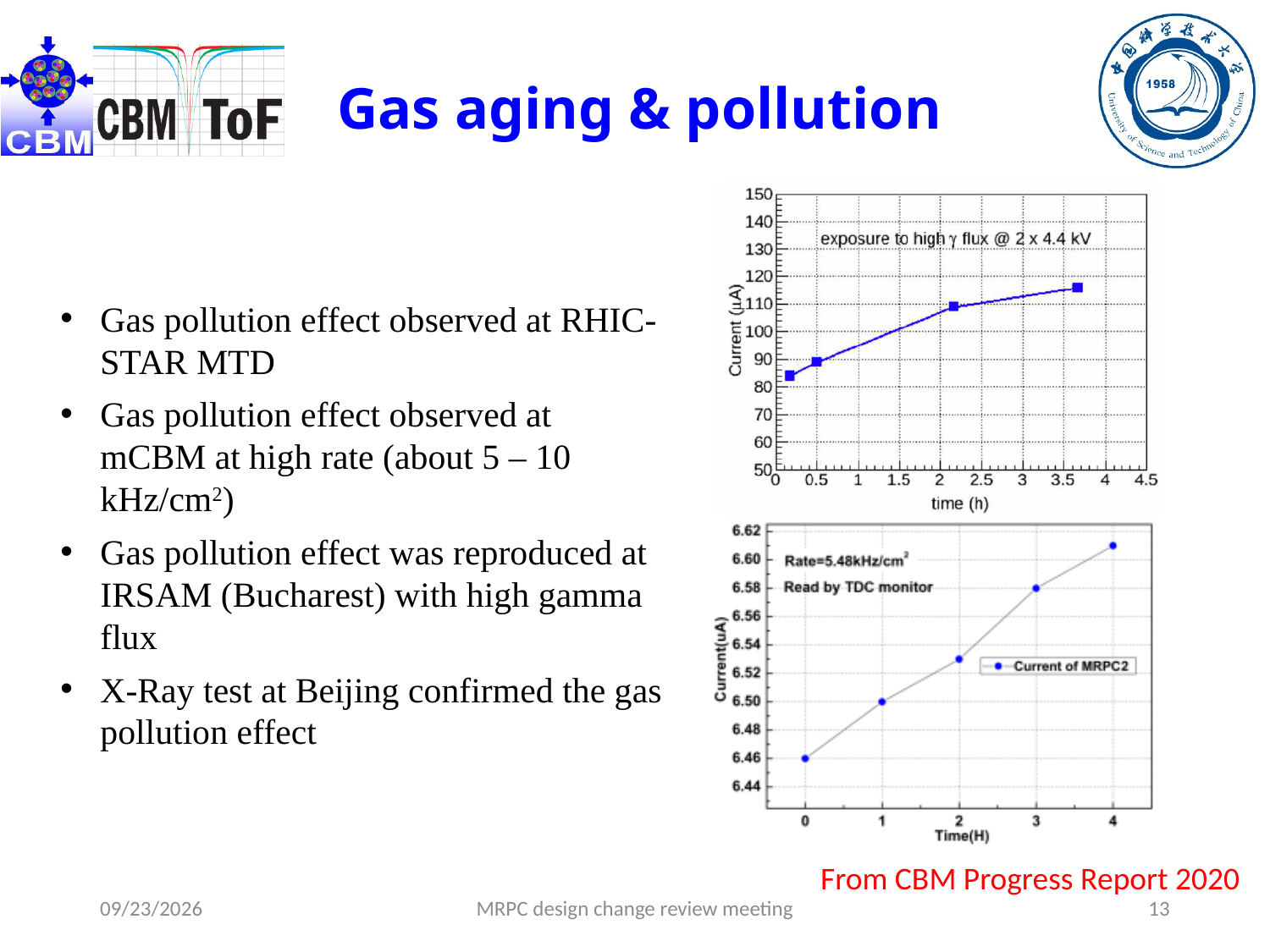
In the bottom chart (Current(uA) vs Time(H)), what is the current at Time 3 H? 6.58 In the top chart (Current vs time (h)), is the value of the last point (near 3.7 h) greater or less than 110? greater How many data points are plotted in the top chart (Current vs time (h))? 4 How many data points are plotted in the bottom chart (Current(uA) vs Time(H))? 5 In the bottom chart (Current(uA) vs Time(H)), is the current at 4 H greater or less than 6.60? greater In the bottom chart (Current(uA) vs Time(H)), what is the difference between the current at 3 H and at 0 H? 0.12 What series name does the legend of the bottom chart (Current(uA) vs Time(H)) show? Current of MRPC2 In the top chart (Current vs time (h)), is the value of the first point (near 0.2 h) greater or less than 90? less What kind of chart is the top chart (Current vs time (h))? line chart In the bottom chart (Current(uA) vs Time(H)), what is the current at Time 0 H? 6.46 In the top chart (Current vs time (h)), which point has the highest current, the first or the last? the last In the top chart (Current vs time (h)), do the values rise or fall as time increases? rise